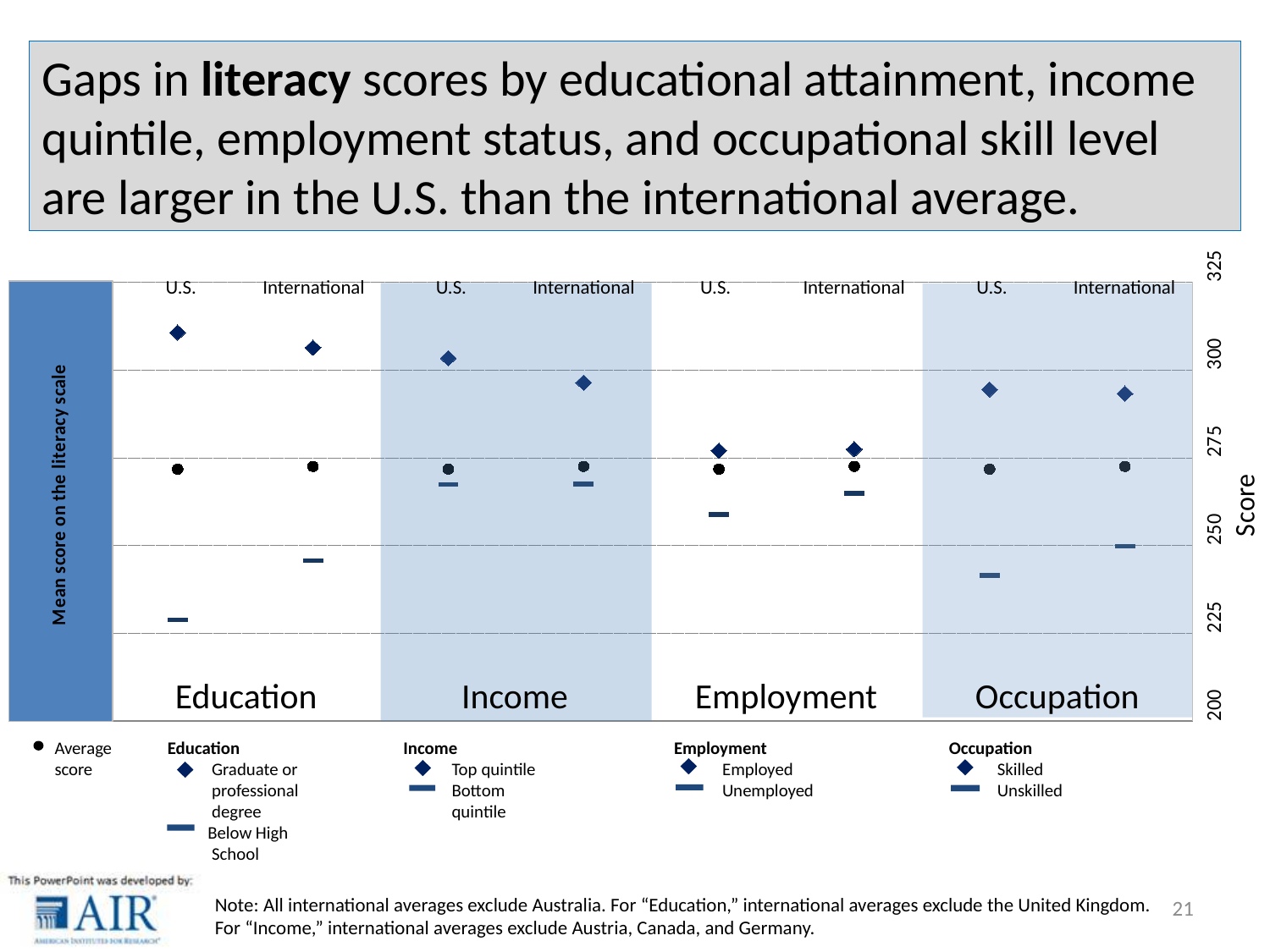
In the Income group, which is higher for Top quintile: the U.S. or the International value? U.S. In the Education group, is the U.S. value for Below High School greater or less than 250? less In the Income group, is the U.S. value for Top quintile greater or less than 275? greater In the Occupation group, which is higher for Unskilled: the U.S. or the International value? International What are the four category groups shown along the bottom of the chart? Education, Income, Employment, Occupation What kind of chart is shown on the slide? Scatter (dot) chart In the Occupation group, is the U.S. value for Unskilled greater or less than 250? less What is the label of the vertical axis on the left of the chart? Mean score on the literacy scale How many category groups are shown along the bottom of the chart? 4 In the Education group, which is higher for Below High School: the U.S. or the International value? International